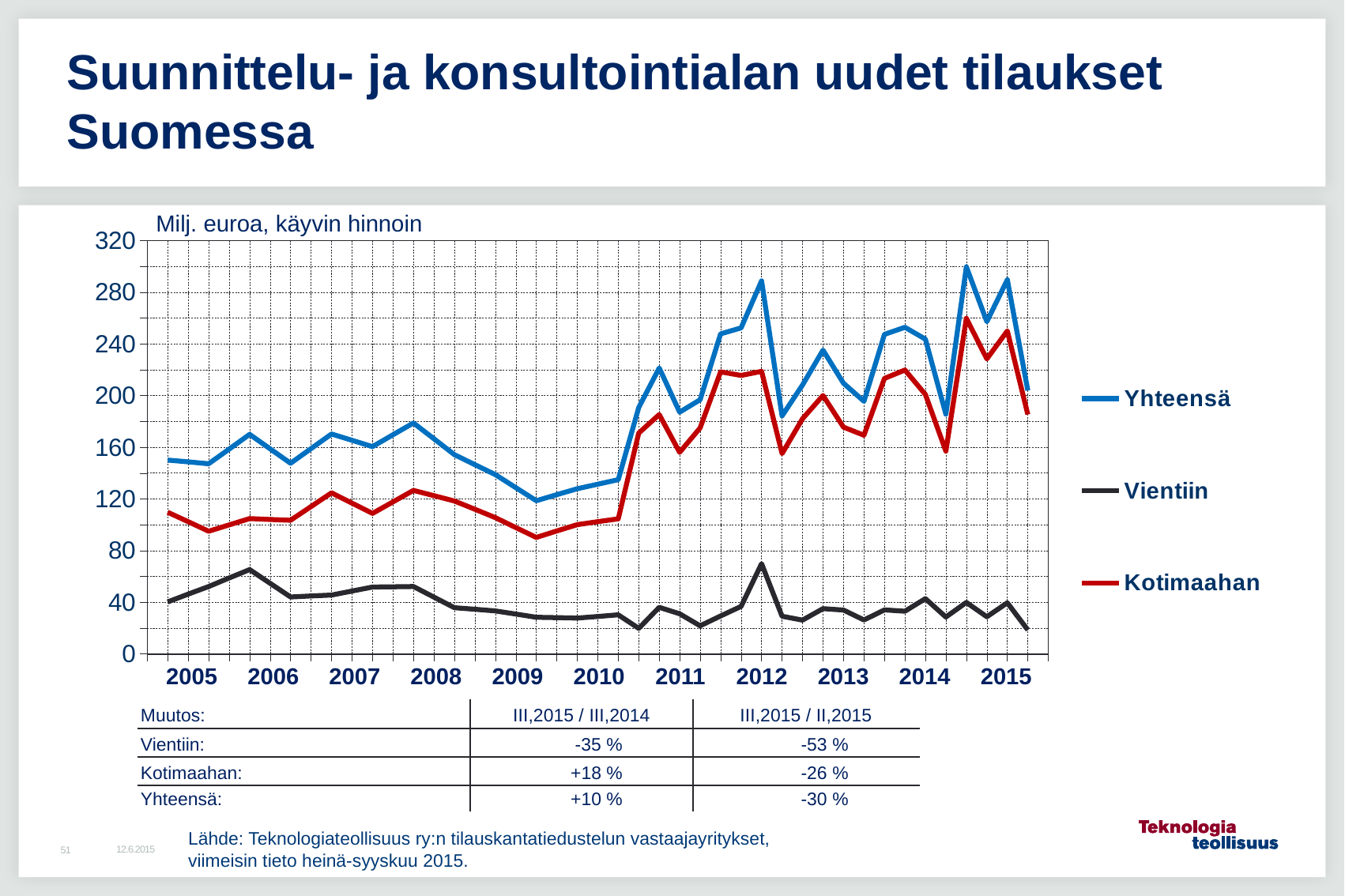
Which series has the lowest values throughout the whole period? Vientiin Is the peak value of Vientiin in 2012 greater or less than 40? greater Which series is plotted with the red line? Kotimaahan Is the lowest value of Kotimaahan in 2009 greater or less than 120? less Does the Yhteensä series rise or fall from 2009 to 2012? rise Is the peak value of Yhteensä in 2014 greater or less than 280? greater How many series does the chart's legend list? 3 What unit is stated above the chart's y axis? Milj. euroa, käyvin hinnoin Which series has the highest values throughout the whole period? Yhteensä What kind of chart is shown on the slide? line chart In 2012, which series is larger, Kotimaahan or Vientiin? Kotimaahan